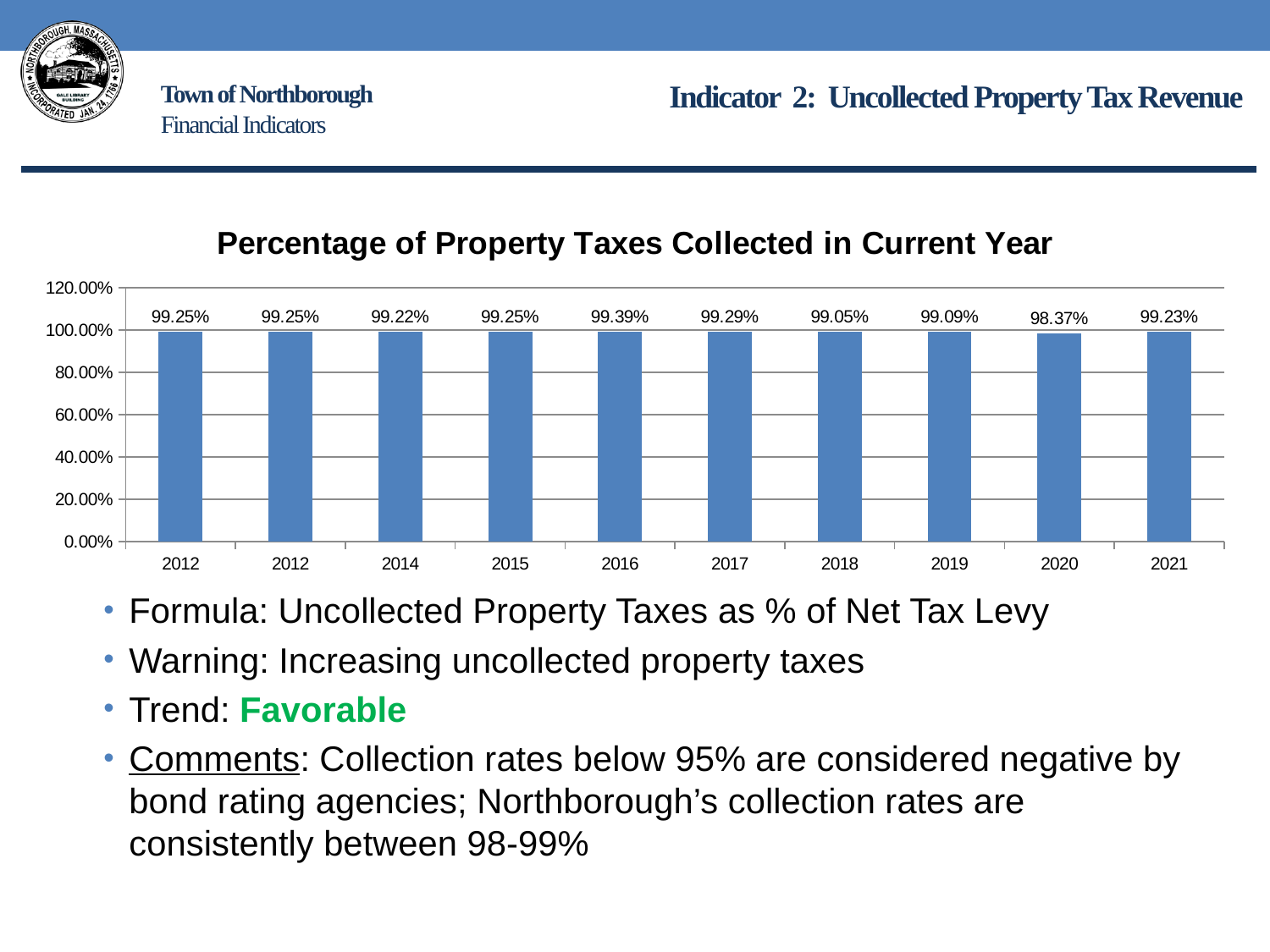
What is the title of the chart? Percentage of Property Taxes Collected in Current Year Which year has the highest percentage of property taxes collected? 2016 Is the value for 2020 greater or less than 80.00%? greater What is the percentage of property taxes collected in 2016? 99.39% Which year has a higher collection percentage, 2018 or 2019? 2019 What type of chart is shown on the slide? bar chart What is the percentage of property taxes collected in 2021? 99.23% Which year has the lowest percentage of property taxes collected? 2020 What is the percentage of property taxes collected in 2020? 98.37% What is the percentage of property taxes collected in 2018? 99.05% What is the difference between the 2016 value and the 2020 value? 1.02% How many bars are plotted in the chart? 10